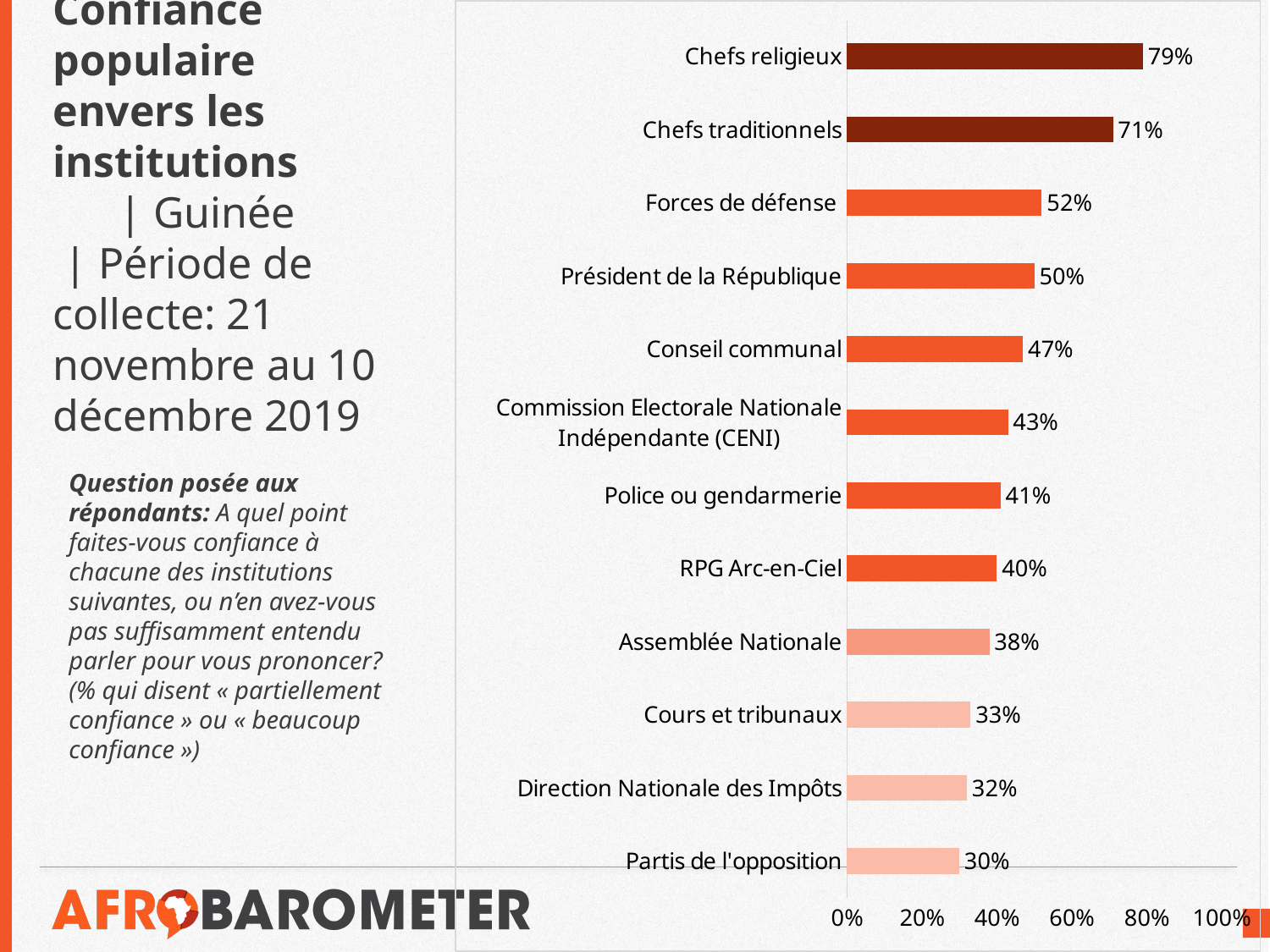
What kind of chart is shown on the slide? Bar chart Which is larger, the value for Police ou gendarmerie or the value for Assemblée Nationale? Police ou gendarmerie Which institution has the highest value? Chefs religieux What is the difference between the values for Forces de défense and Cours et tribunaux? 19% What is the value for Direction Nationale des Impôts? 32% What is the value for Chefs religieux? 79% How many institutions are shown in the chart? 12 What is the difference between the values for Chefs religieux and Chefs traditionnels? 8% Is the value for Conseil communal greater or less than 40%? greater Which institution has the lowest value? Partis de l'opposition What is the value for Commission Electorale Nationale Indépendante (CENI)? 43% What is the value for Président de la République? 50%